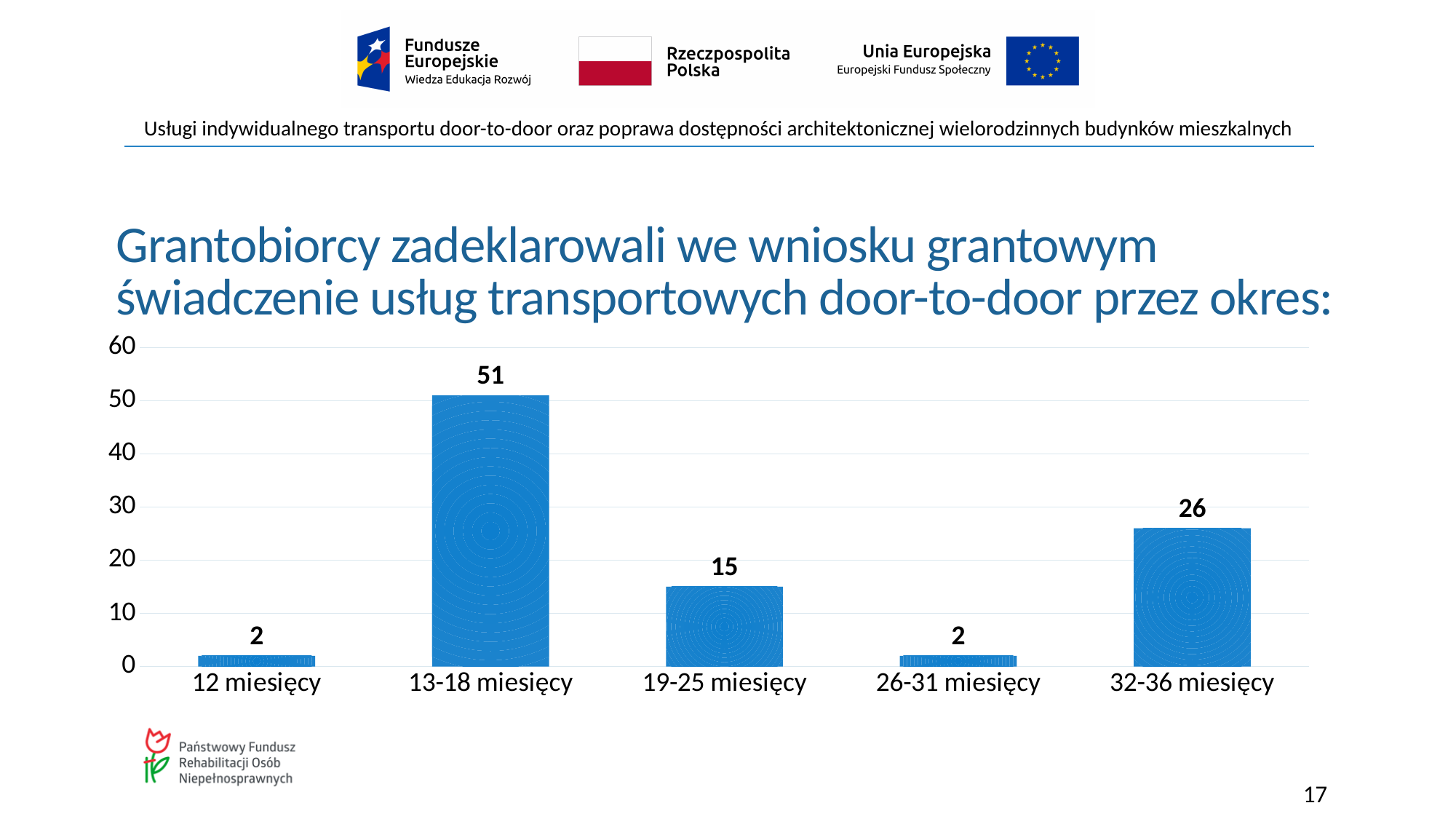
Which is larger, the value for 19-25 miesięcy or the value for 32-36 miesięcy? 32-36 miesięcy What is the highest value shown on the vertical axis? 60 What is the value for 13-18 miesięcy? 51 What is the difference between the values for 13-18 miesięcy and 32-36 miesięcy? 25 Is the value for 13-18 miesięcy greater or less than 40? greater What is the difference between the values for 19-25 miesięcy and 26-31 miesięcy? 13 What is the value for 19-25 miesięcy? 15 What is the value for 32-36 miesięcy? 26 What kind of chart is shown on the slide? bar chart How many categories are shown on the x axis? 5 Which category has the highest value? 13-18 miesięcy What is the value for 12 miesięcy? 2